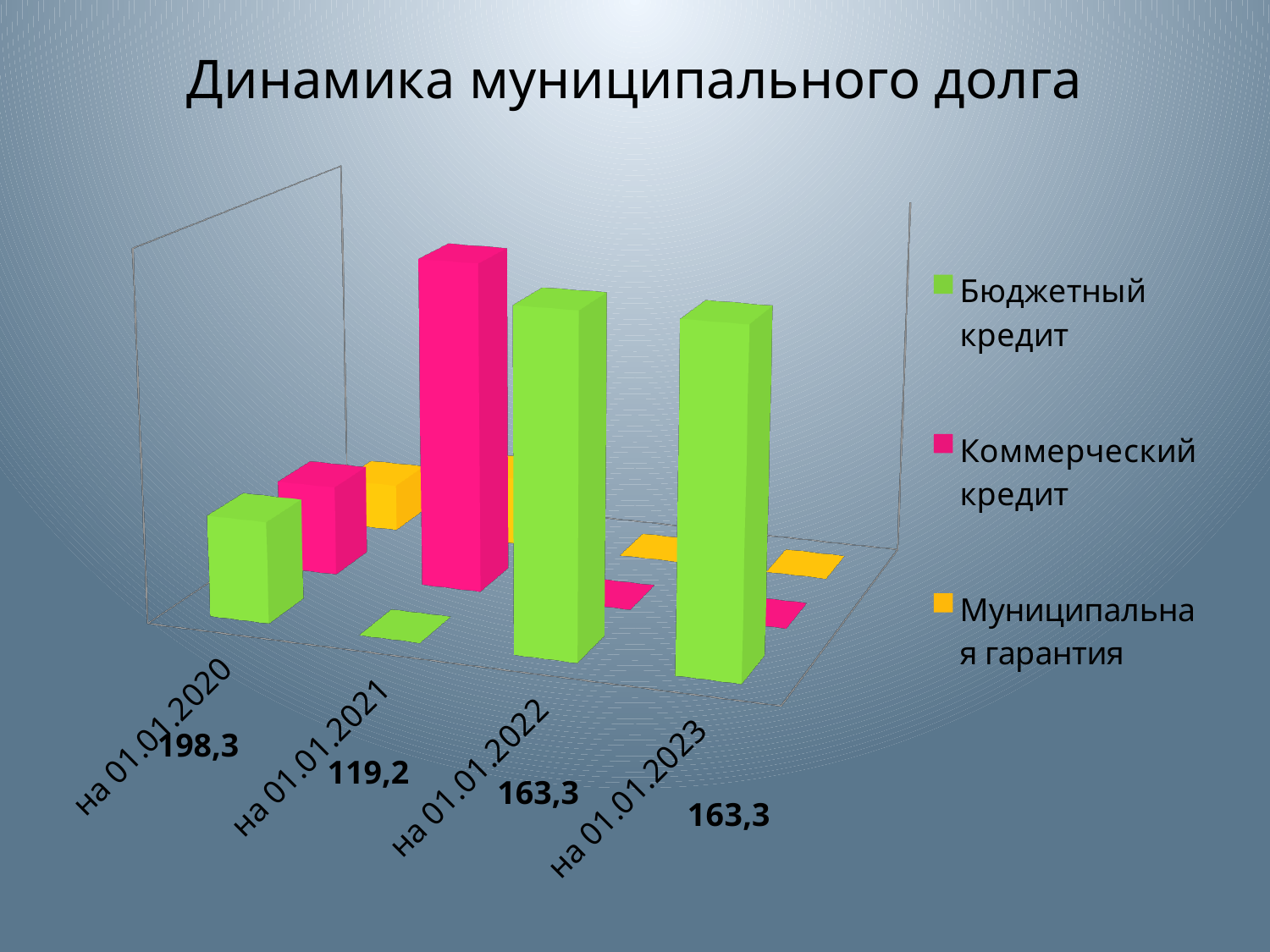
On 01.01.2023, which is larger: Бюджетный кредит or Коммерческий кредит? Бюджетный кредит What is the title of the chart? Динамика муниципального долга What number is printed below the category на 01.01.2020? 198,3 For which date is the Бюджетный кредит bar the smallest? на 01.01.2021 How many series does the legend list? 3 Which colour represents Бюджетный кредит in the legend? green On 01.01.2020, which is larger: Бюджетный кредит or Коммерческий кредит? Бюджетный кредит What number is printed below the category на 01.01.2021? 119,2 How many categories (dates) are shown on the x axis? 4 What type of chart is shown on the slide? bar chart For which date is the Коммерческий кредит bar the tallest? на 01.01.2021